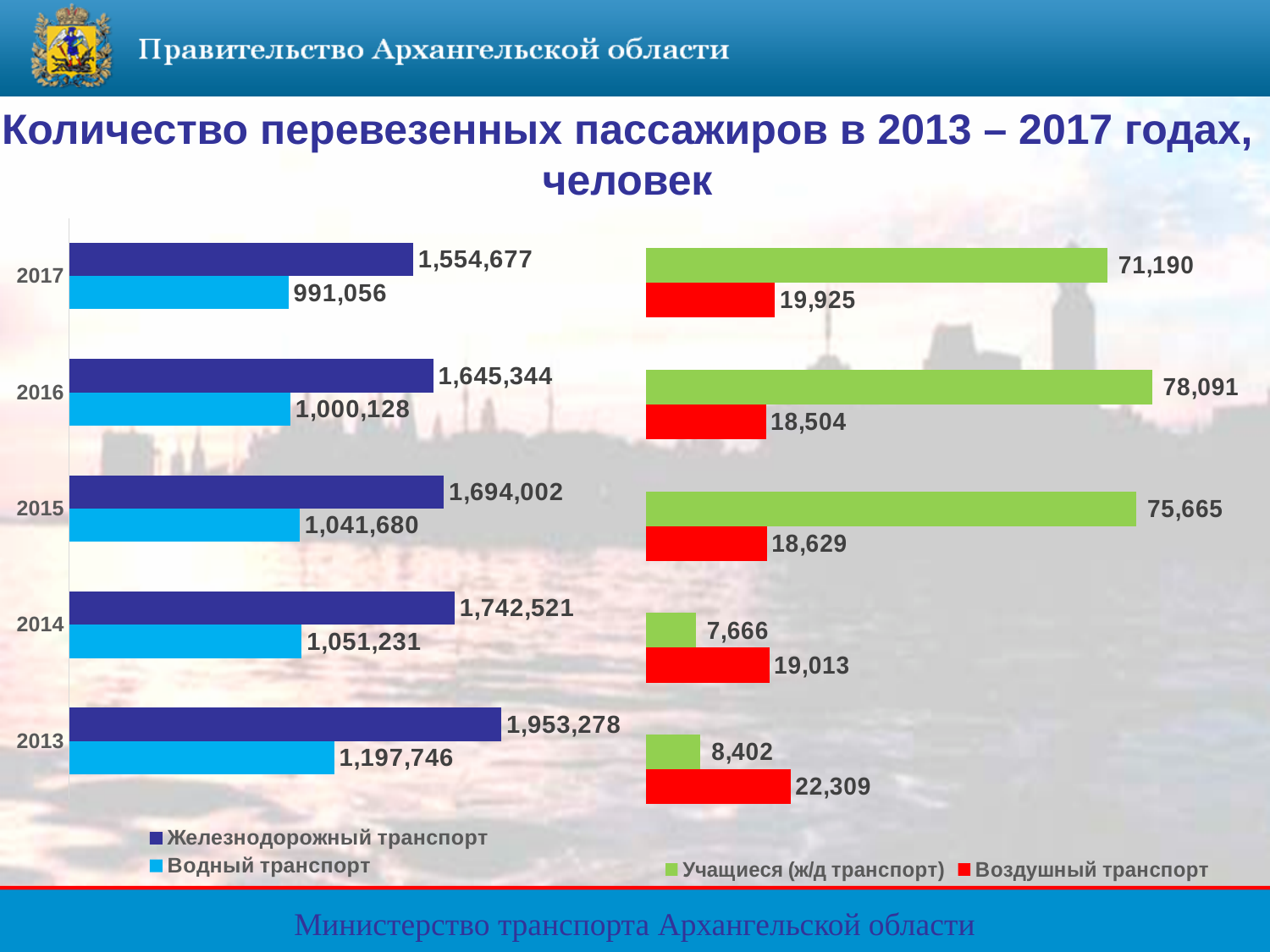
In the left chart, what is the value for Железнодорожный транспорт in 2013? 1,953,278 In the right chart, which is larger in 2013: Учащиеся (ж/д транспорт) or Воздушный транспорт? Воздушный транспорт In the left chart, which year has the highest value for Железнодорожный транспорт? 2013 In the right chart, what is the value for Учащиеся (ж/д транспорт) in 2014? 7,666 In the right chart, what is the value for Воздушный транспорт in 2017? 19,925 In the left chart, what is the difference between Железнодорожный транспорт and Водный транспорт in 2017? 563,621 How many series does the legend of the right chart list? 2 In the right chart, which year has the lowest value for Учащиеся (ж/д транспорт)? 2014 In the left chart, does the value for Водный транспорт rise or fall from 2013 to 2017? Fall How many years are shown in the left chart? 5 In the left chart, what is the value for Водный транспорт in 2016? 1,000,128 What type of chart is the left chart? Bar chart